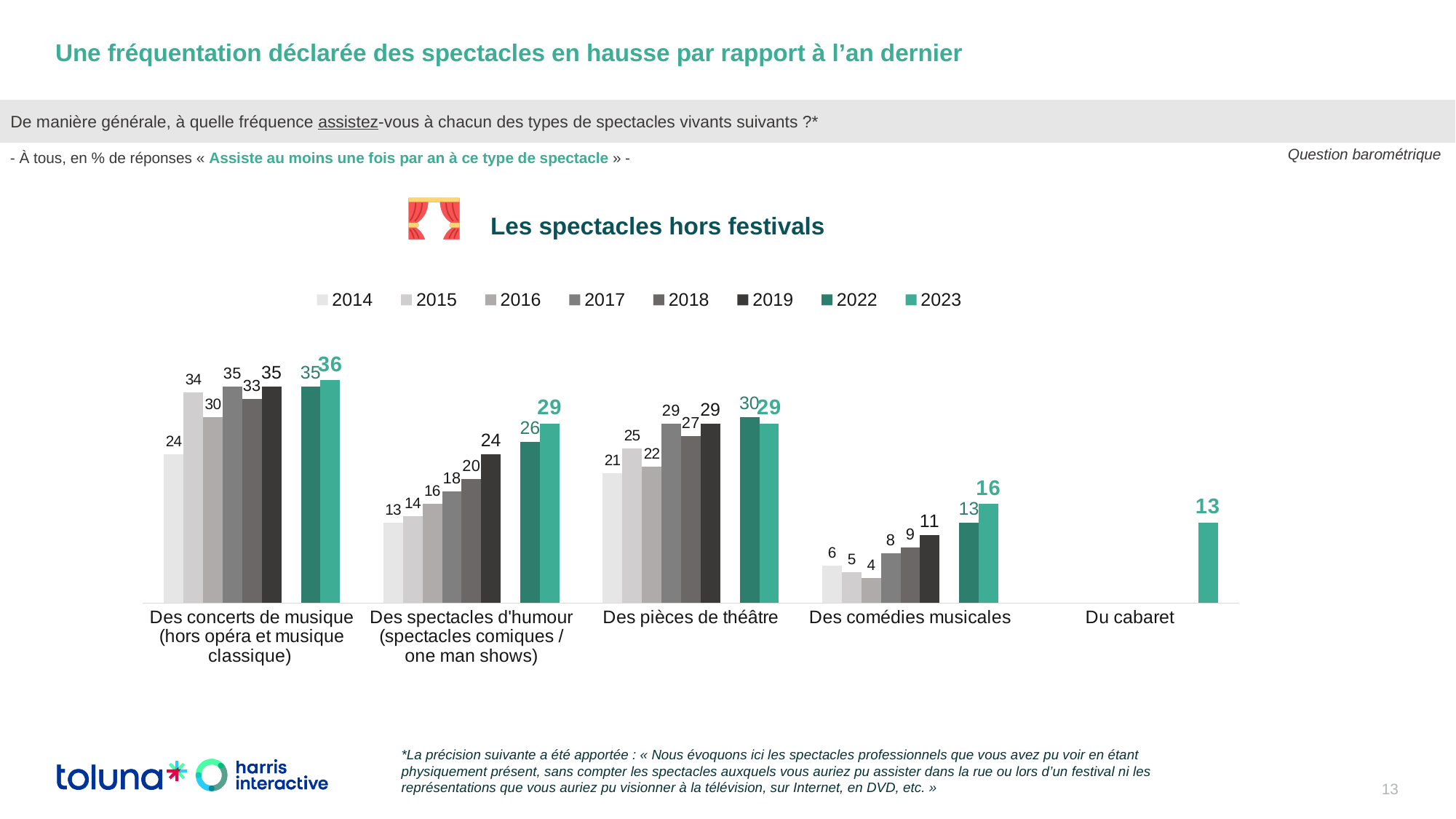
Which year has the lowest value for 'Des comédies musicales'? 2016 Which is larger for 'Des spectacles d'humour (spectacles comiques / one man shows)': the 2019 value or the 2023 value? 2023 What is the 2014 value for 'Des spectacles d'humour (spectacles comiques / one man shows)'? 13 Do the values for 'Des spectacles d'humour (spectacles comiques / one man shows)' rise or fall from 2014 to 2023? Rise What is the difference between the 2023 and 2022 values for 'Des comédies musicales'? 3 What is the 2023 value for 'Des concerts de musique (hors opéra et musique classique)'? 36 What is the 2023 value for 'Du cabaret'? 13 Which category has the highest 2023 value? Des concerts de musique (hors opéra et musique classique) How many series does the legend list? 8 How many categories are shown on the x axis? 5 What is the 2022 value for 'Des pièces de théâtre'? 30 What kind of chart is shown? Bar chart